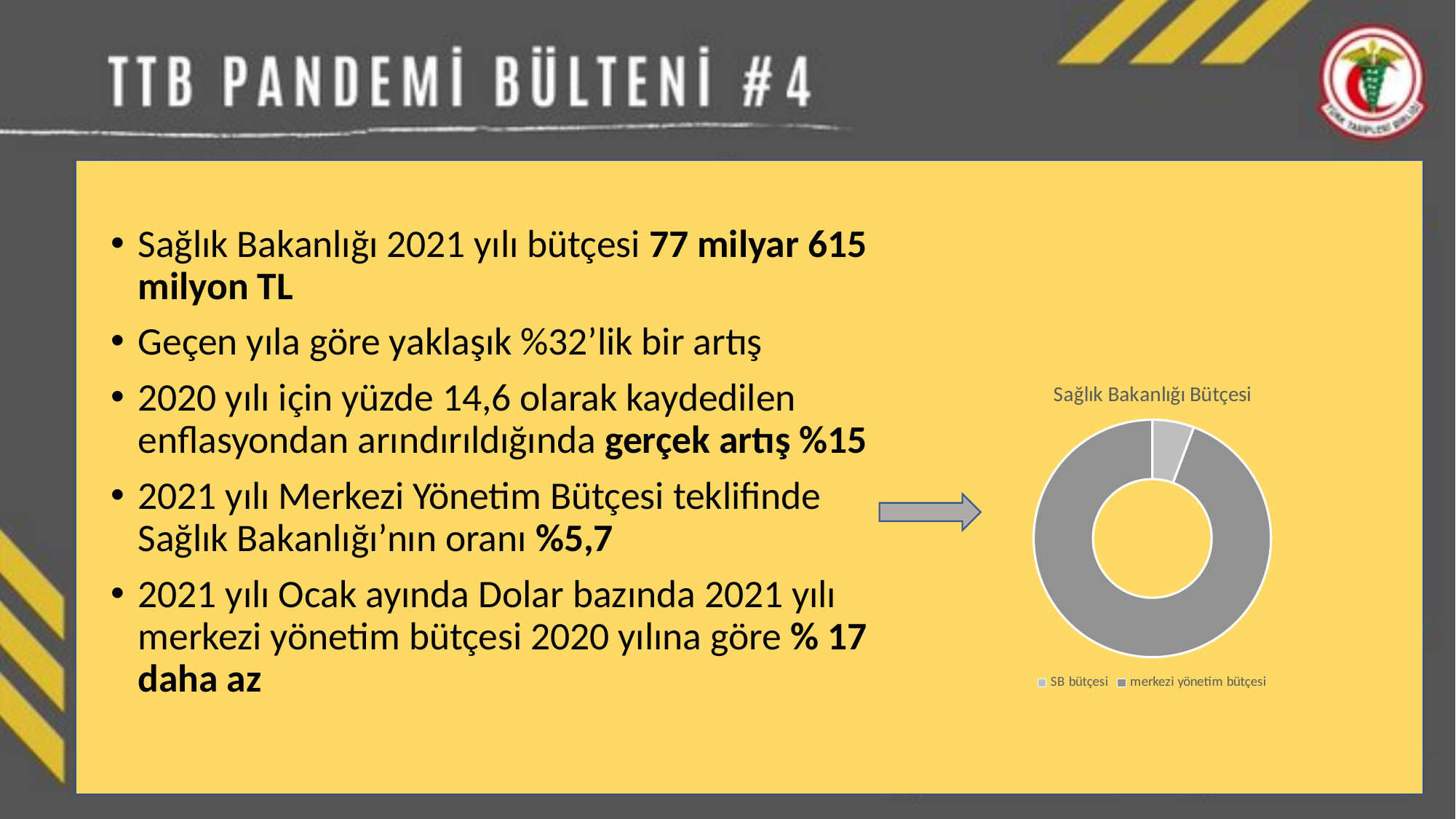
How many slices does the doughnut chart have? 2 Which slice of the chart is larger, SB bütçesi or merkezi yönetim bütçesi? merkezi yönetim bütçesi Which category takes up the largest share of the doughnut chart? merkezi yönetim bütçesi What is the title of the chart on the slide? Sağlık Bakanlığı Bütçesi What are the two legend entries of the chart? SB bütçesi and merkezi yönetim bütçesi How many entries does the chart's legend list? 2 What kind of chart is shown on the slide? Doughnut chart Which category takes up the smallest share of the doughnut chart? SB bütçesi